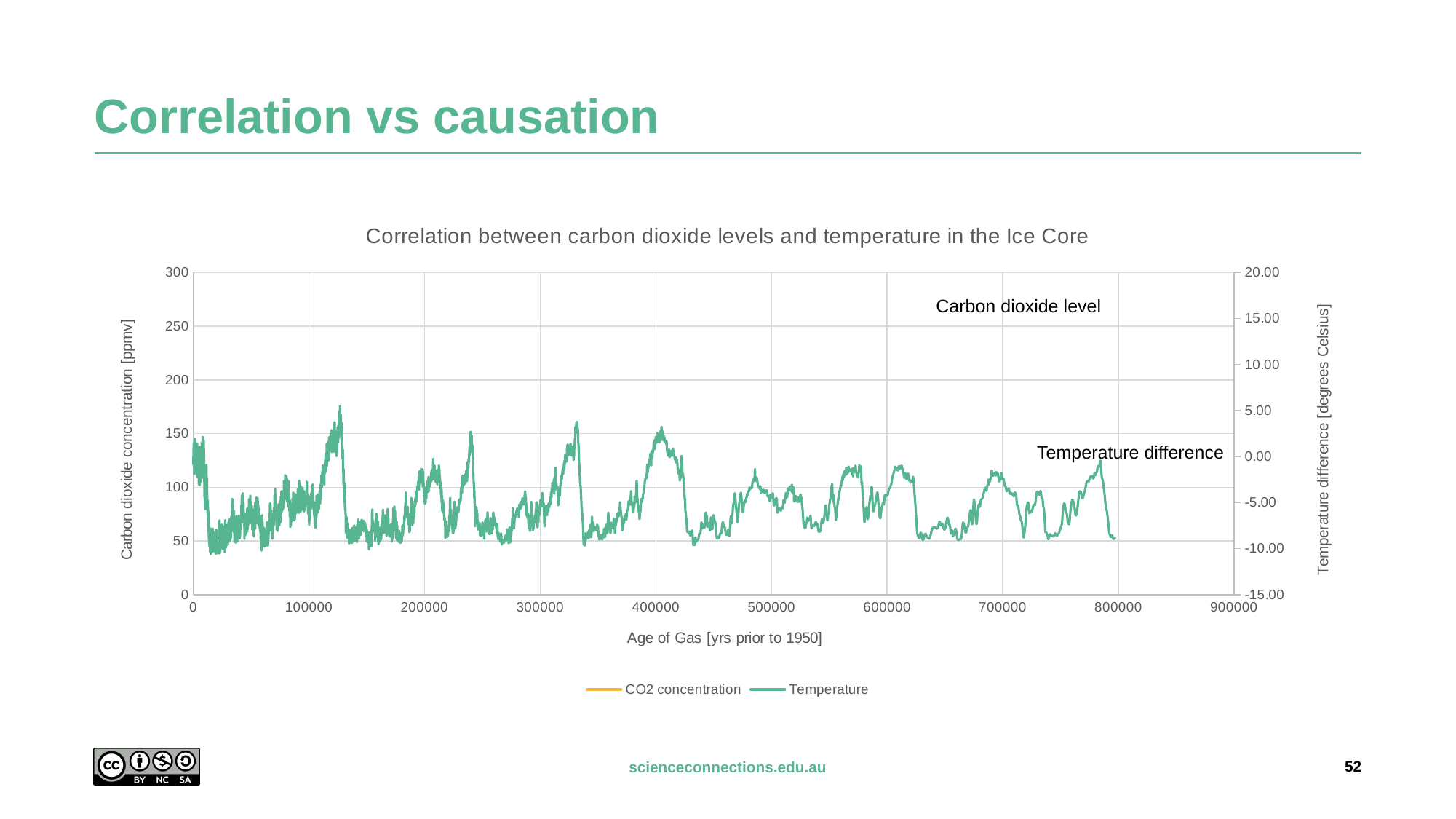
What kind of chart is shown on the slide? line chart Is the Temperature difference value at about 430000 years prior to 1950 greater or less than -5.00 on the right axis? less Is the Temperature difference value at about 400000 years prior to 1950 greater or less than 0.00 on the right axis? greater Which two series are listed in the chart's legend? CO2 concentration and Temperature Is the Temperature difference value at about 620000 years prior to 1950 greater or less than -5.00 on the right axis? less How many series does the chart's legend list? 2 What is the title of the chart? Correlation between carbon dioxide levels and temperature in the Ice Core